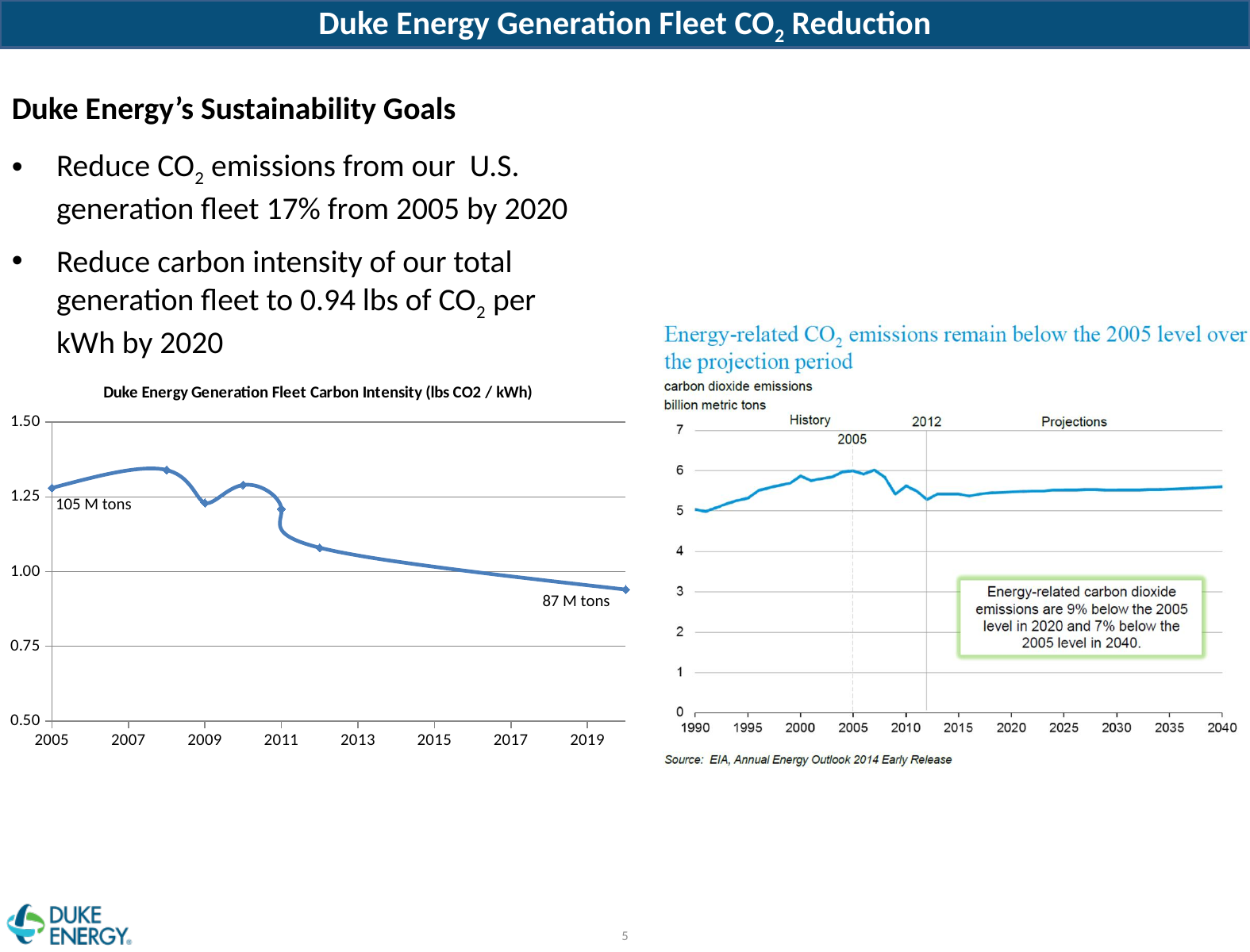
In the left carbon intensity chart, is the value for 2012 greater or less than 1.00? greater In the left carbon intensity chart, which is larger: the value for 2008 or the value for 2012? 2008 In the right EIA chart of energy-related CO2 emissions, is the value for 2005 greater or less than 5? greater In the left carbon intensity chart, is the value at the end of the line (2020) greater or less than 1.00? less In the right EIA chart, what is the source cited below the chart? EIA, Annual Energy Outlook 2014 Early Release In the left carbon intensity chart, what annotation label is shown near the end of the line around 2020? 87 M tons In the right EIA chart, what unit is given for carbon dioxide emissions on the y axis? billion metric tons What type of chart is the 'Duke Energy Generation Fleet Carbon Intensity (lbs CO2 / kWh)' chart on the left? line chart In the left carbon intensity chart, what annotation label is shown near the 2005 start of the line? 105 M tons In the left carbon intensity chart, does the carbon intensity overall rise or fall from 2005 to 2020? fall